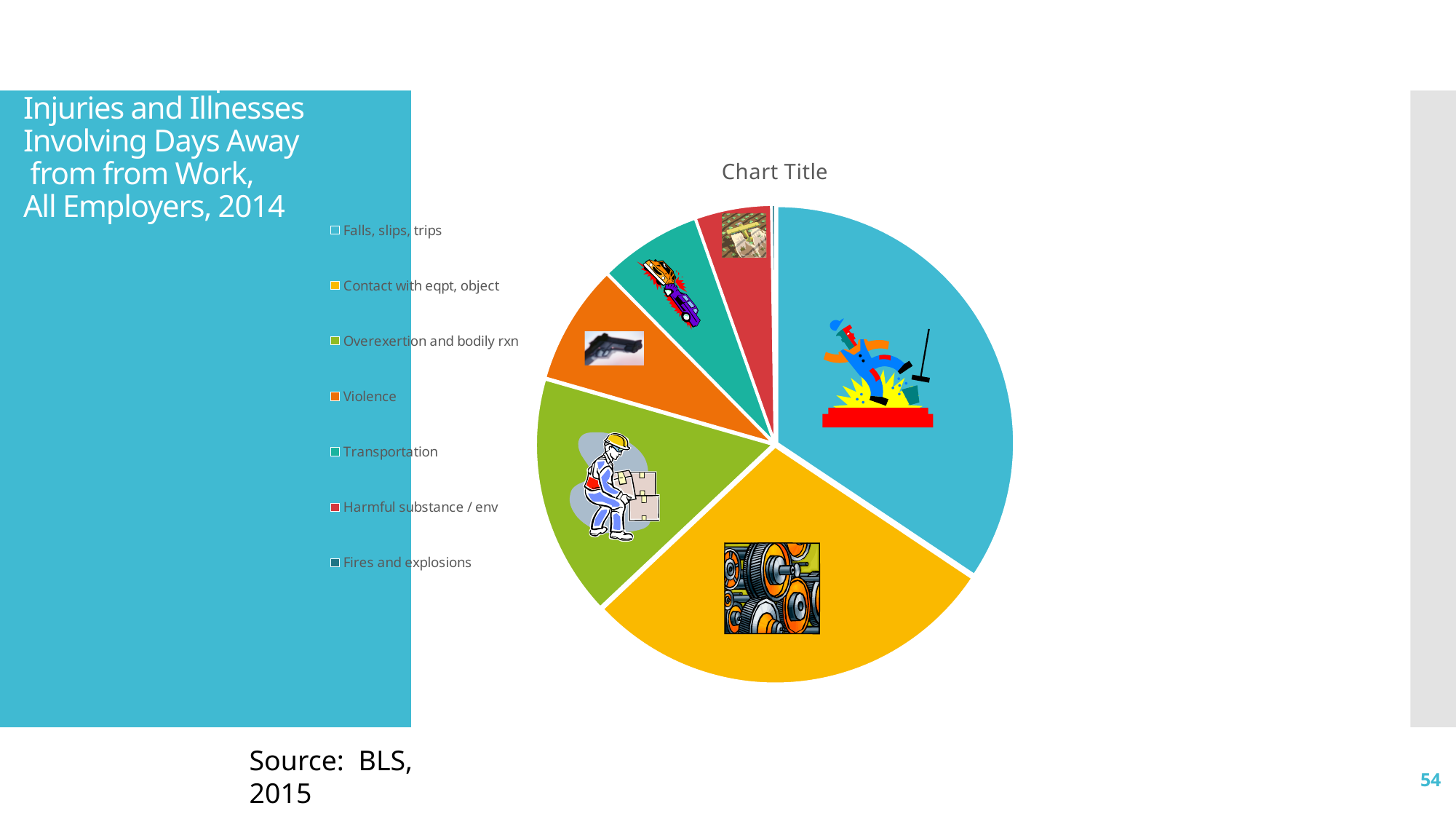
How many categories does the legend of the pie chart list? 7 Which slice is larger, Overexertion and bodily rxn or Violence? Overexertion and bodily rxn Which category is listed first in the pie chart's legend? Falls, slips, trips What title is printed above the pie chart? Chart Title Which slice is smaller, Violence or Harmful substance / env? Harmful substance / env Which slice is larger, Contact with eqpt, object or Overexertion and bodily rxn? Contact with eqpt, object Which category has the largest slice of the pie chart? Falls, slips, trips What kind of chart is shown on the slide? Pie chart